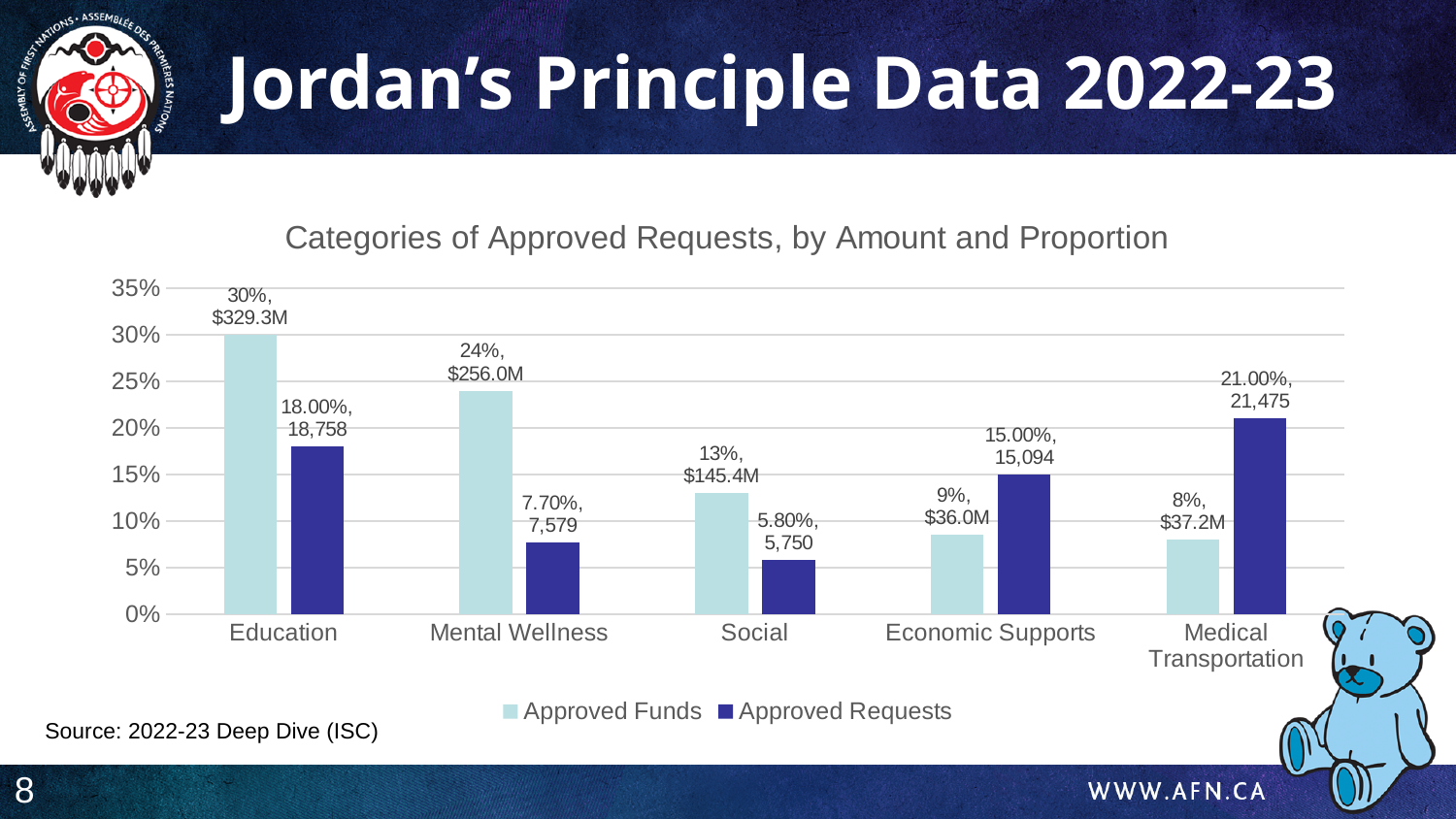
Which is larger for Economic Supports: the Approved Funds proportion or the Approved Requests proportion? Approved Requests How many categories are shown on the x axis? 5 What dollar amount of Approved Funds is shown for Mental Wellness? $256.0M Which category has the lowest Approved Funds proportion? Medical Transportation How many series does the legend list? 2 What is the data label for Approved Requests in the Medical Transportation category? 21.00%, 21,475 Which category has the lowest Approved Requests proportion? Social What is the difference in Approved Requests count between Medical Transportation and Education? 2,717 What number of Approved Requests is shown for Economic Supports? 15,094 Which category has the highest Approved Funds proportion? Education What is the data label for Approved Funds in the Education category? 30%, $329.3M What type of chart is shown on the slide? Bar chart